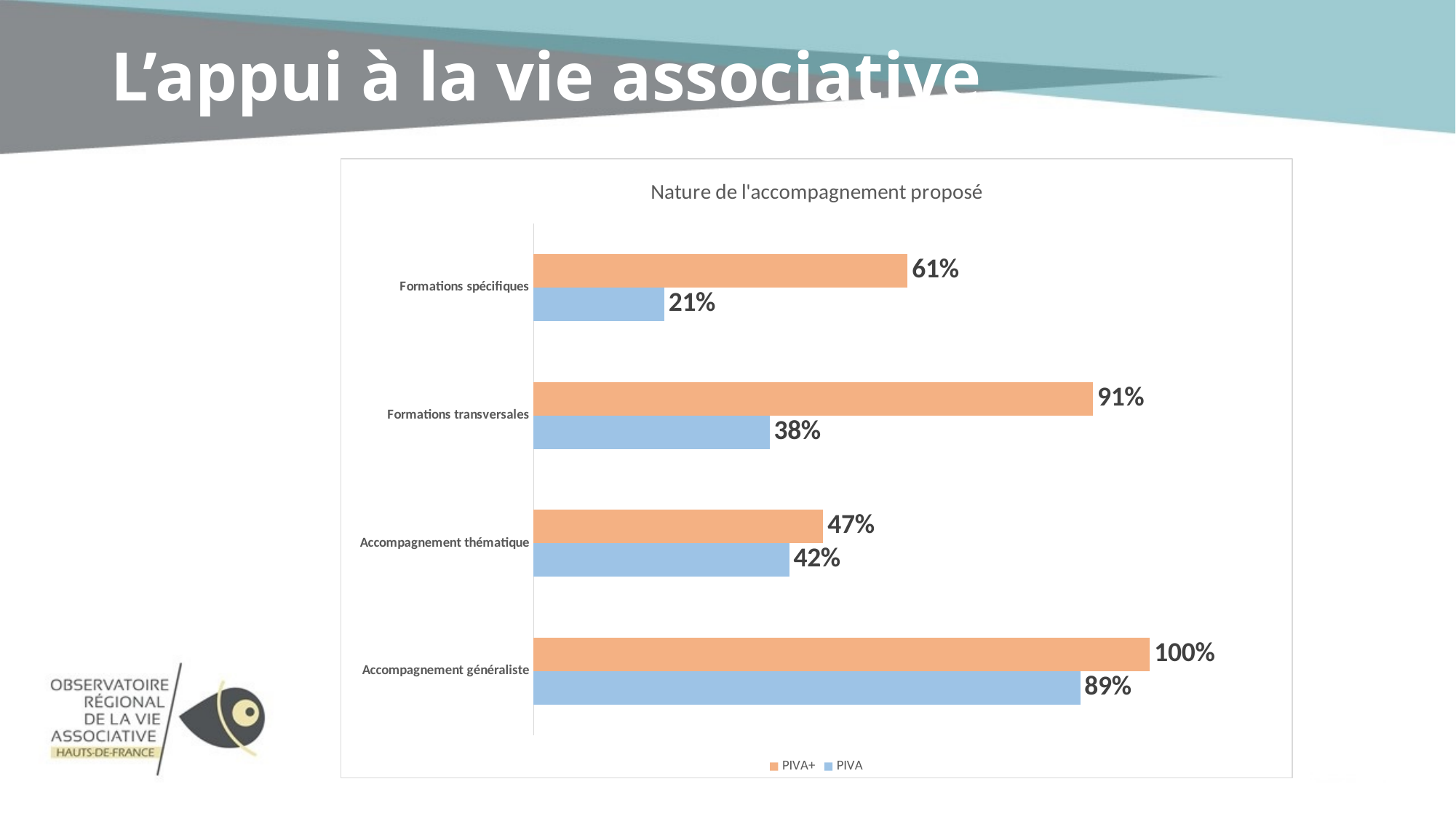
What is the PIVA value for Accompagnement généraliste? 89% What is the PIVA+ value for Formations spécifiques? 61% What kind of chart is shown on the slide? Bar chart Which category has the highest PIVA+ value? Accompagnement généraliste How many series does the legend list? 2 What is the title of the chart? Nature de l'accompagnement proposé Which category has the lowest PIVA value? Formations spécifiques How many categories are shown on the chart? 4 Which is larger for Accompagnement thématique, the PIVA+ value or the PIVA value? PIVA+ Which colour represents the PIVA series in the chart? Blue What is the PIVA value for Formations transversales? 38% What is the difference between the PIVA+ and PIVA values for Formations transversales? 53%